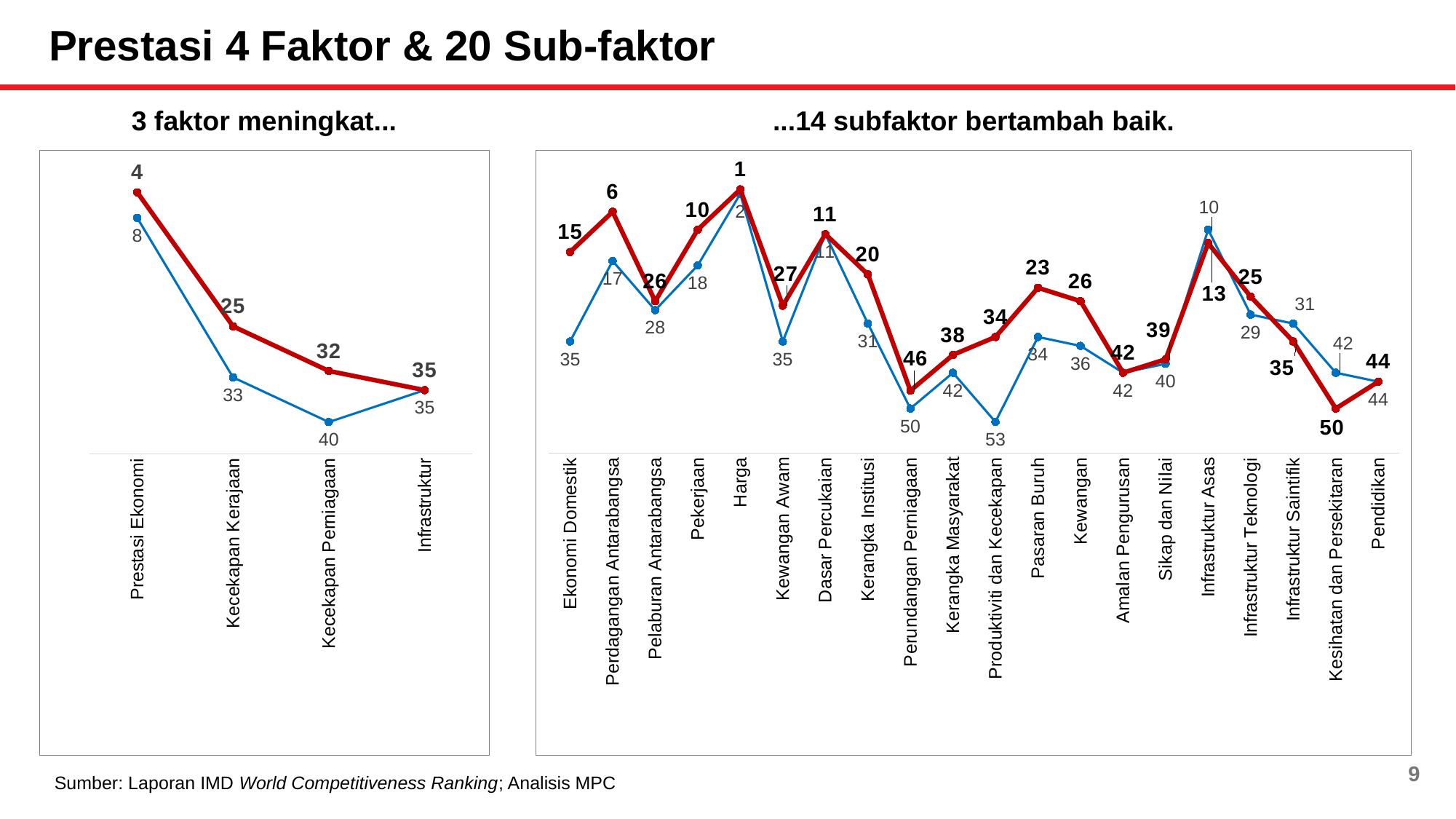
How many categories are shown on the x axis of the left chart "3 faktor meningkat..."? 4 In the right chart "...14 subfaktor bertambah baik.", which category has the largest labelled value on the red (bold) line? Kesihatan dan Persekitaran In the right chart "...14 subfaktor bertambah baik.", what is the difference between the blue and red values for Ekonomi Domestik? 20 In the right chart "...14 subfaktor bertambah baik.", which is larger for Infrastruktur Asas: the red (bold) line's value or the blue line's value? red (bold) line How many categories are shown on the x axis of the right chart "...14 subfaktor bertambah baik."? 20 In the left chart "3 faktor meningkat...", what is the blue line's value for Kecekapan Perniagaan? 40 In the left chart "3 faktor meningkat...", what is the red (bold) line's value for Prestasi Ekonomi? 4 In the right chart "...14 subfaktor bertambah baik.", what is the red (bold) line's value for Kesihatan dan Persekitaran? 50 In the right chart "...14 subfaktor bertambah baik.", what is the red (bold) line's value for Harga? 1 What type of chart is the left chart titled "3 faktor meningkat..."? line chart In the left chart "3 faktor meningkat...", what is the difference between the blue and red values for Kecekapan Kerajaan? 8 In the right chart "...14 subfaktor bertambah baik.", what is the blue line's value for Produktiviti dan Kecekapan? 53